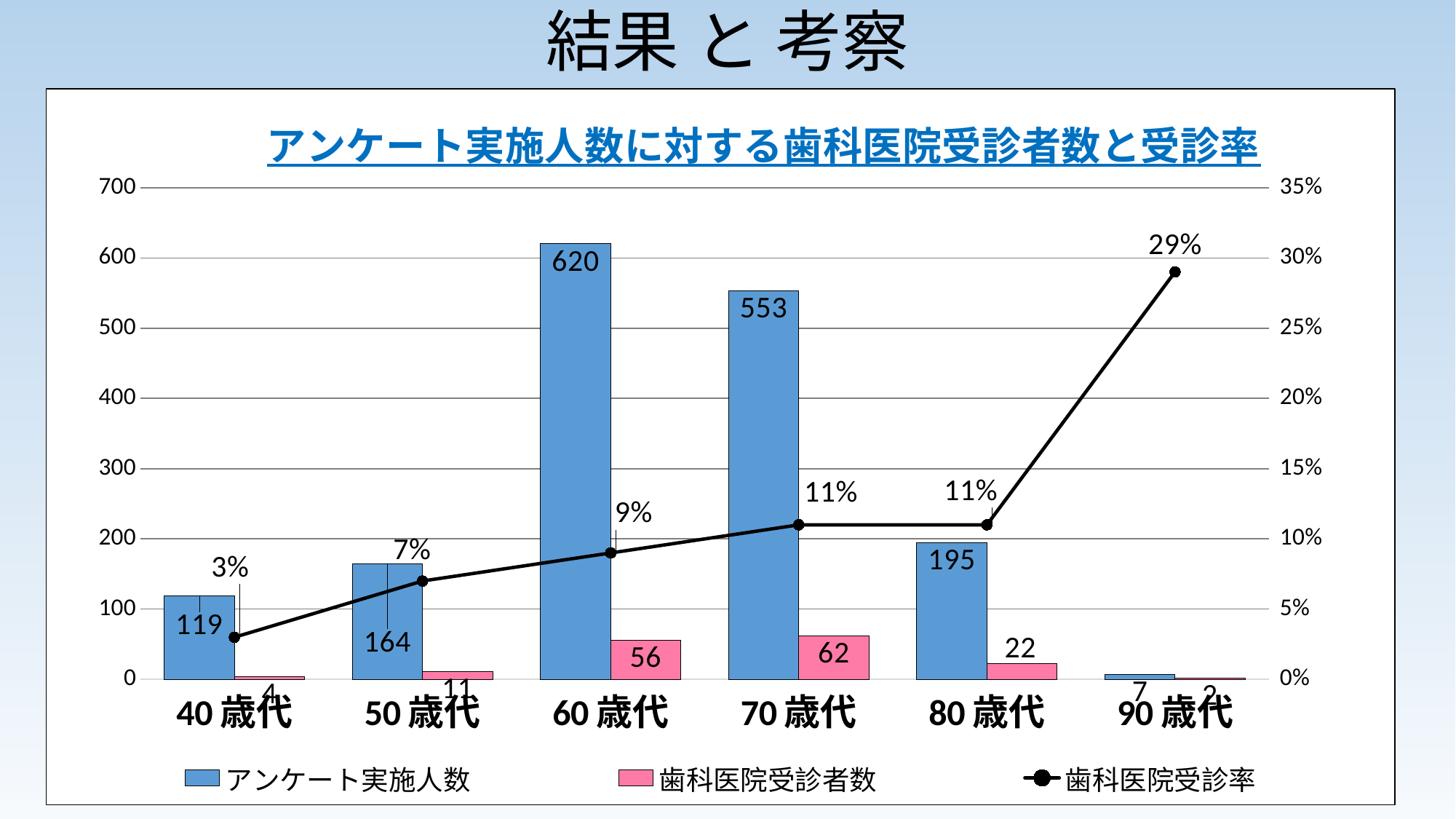
What is the 歯科医院受診率 for 90歳代? 29% Which is larger, the 歯科医院受診者数 for 60歳代 or for 70歳代? 70歳代 Which age group has the highest アンケート実施人数? 60歳代 How many series does the legend list? 3 Does the 歯科医院受診率 line rise or fall from 40歳代 to 90歳代? rise Is the アンケート実施人数 for 80歳代 greater or less than 200? less How many age groups are shown on the x axis? 6 What is the title of the chart? アンケート実施人数に対する歯科医院受診者数と受診率 What is the difference between the アンケート実施人数 for 60歳代 and 70歳代? 67 What is the 歯科医院受診者数 value for 70歳代? 62 Which age group has the lowest 歯科医院受診者数? 90歳代 What is the アンケート実施人数 value for 60歳代? 620